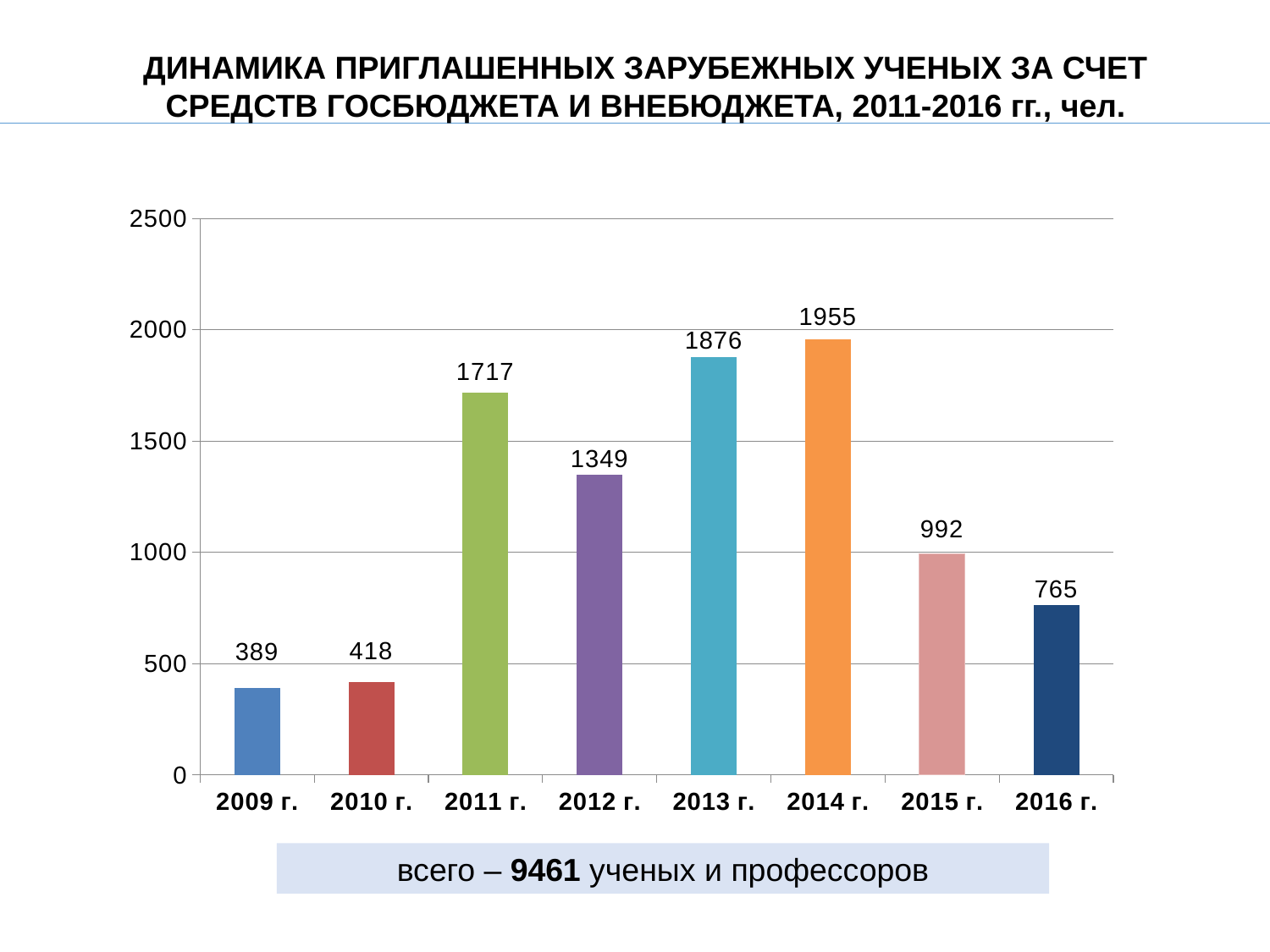
What kind of chart is this? bar chart What is the difference between the values for 2011 г. and 2012 г.? 368 How many years are shown on the x axis? 8 Which is larger, the value for 2015 г. or the value for 2016 г.? 2015 г. What is the value for 2009 г.? 389 Do the values rise or fall from 2014 г. to 2016 г.? fall Which year has the lowest value? 2009 г. What is the value for 2015 г.? 992 What is the value for 2011 г.? 1717 Is the value for 2012 г. greater or less than 1500? less What is the difference between the values for 2014 г. and 2013 г.? 79 Which year has the highest value? 2014 г.